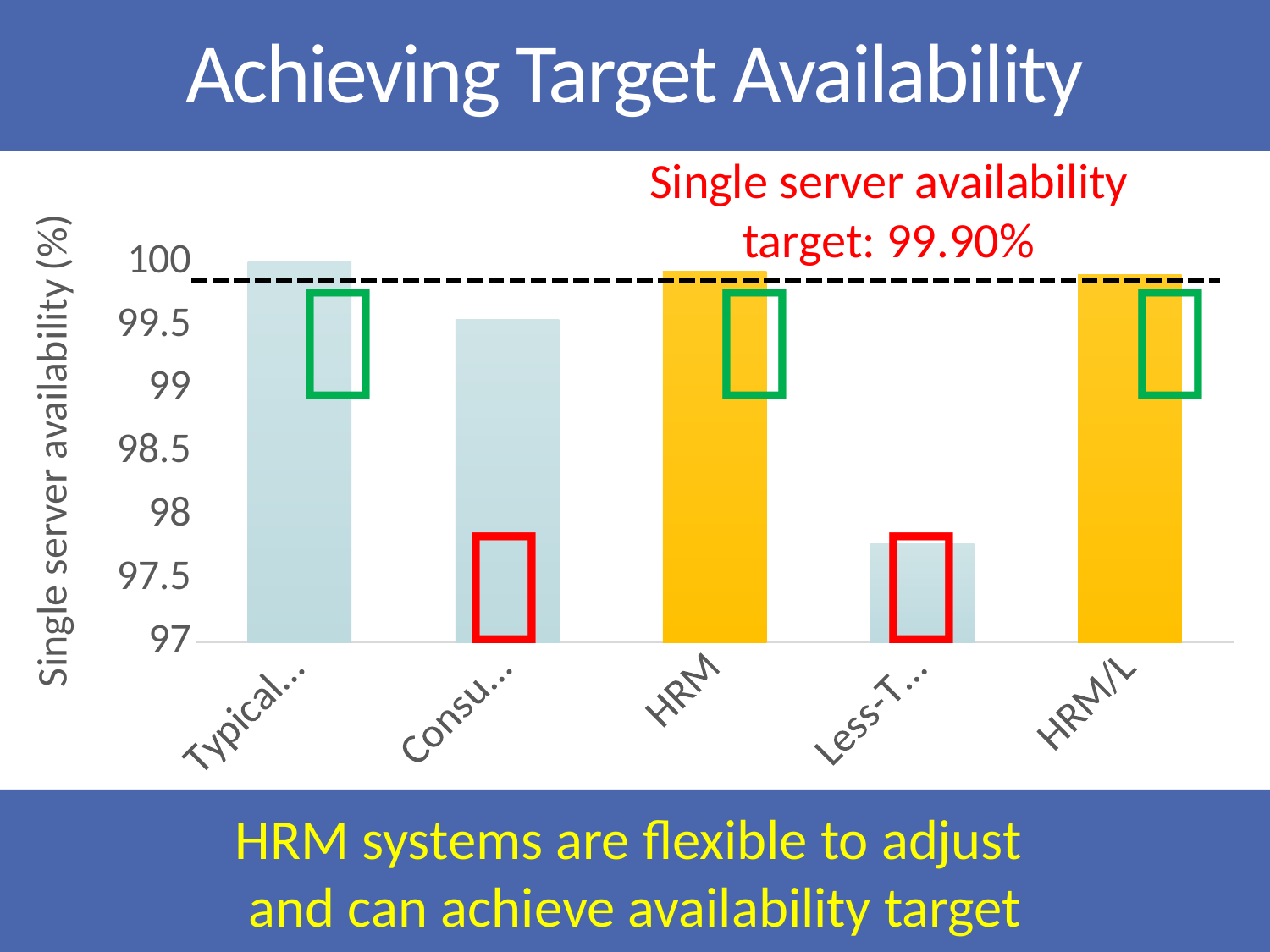
Is the value for HRM/L greater or less than 99.5? greater Is the value for HRM greater or less than 99.5? greater Is the value for HRM greater or less than 99? greater What is the title of the vertical axis? Single server availability (%) What kind of chart is shown on the slide? bar chart How many bars are plotted in the chart? 5 What single server availability target is marked by the dashed line? 99.90%